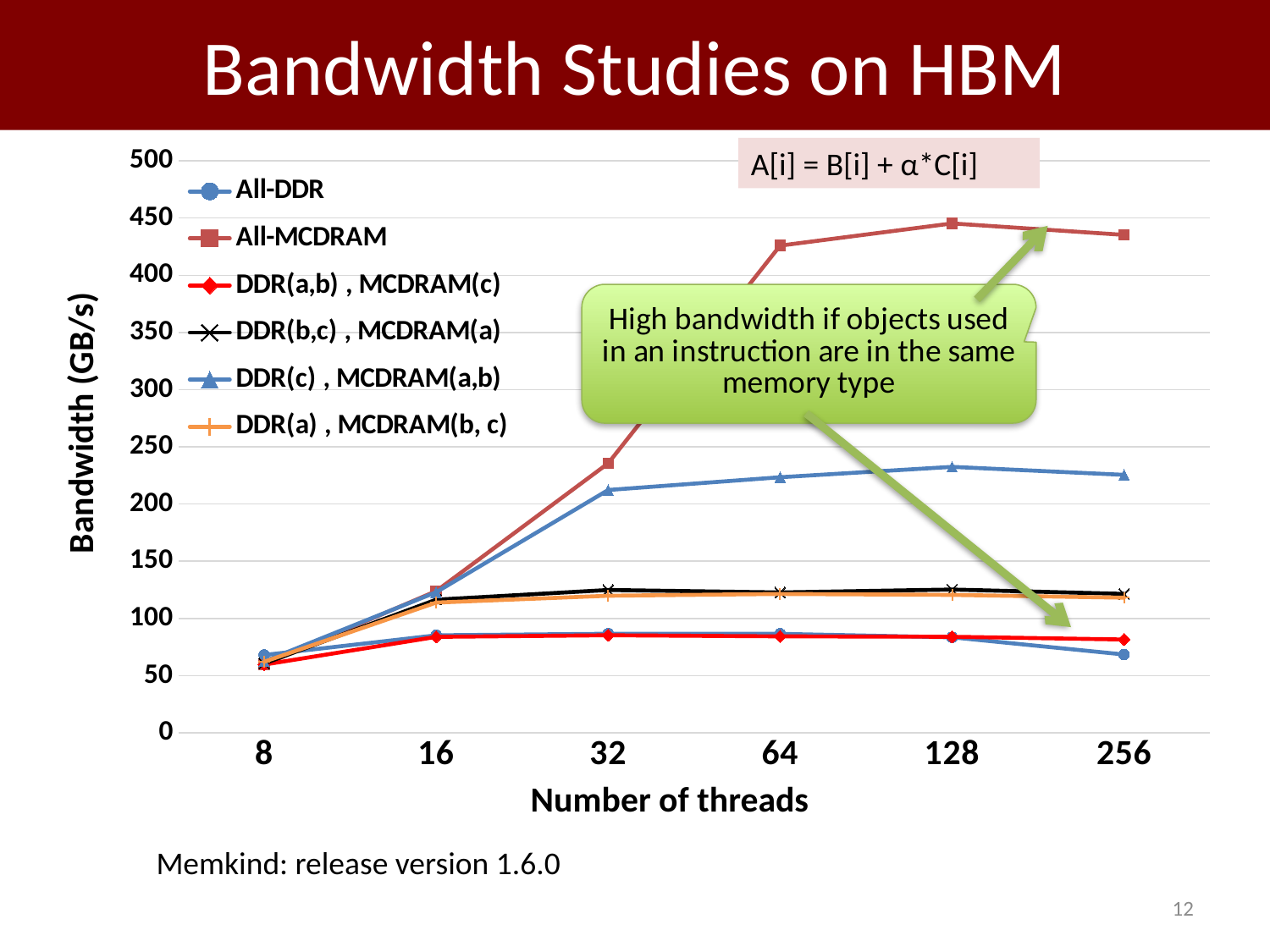
At 32 threads, which is larger: All-MCDRAM or DDR(c) , MCDRAM(a,b)? All-MCDRAM Is the value for All-MCDRAM at 128 threads greater or less than 400? greater Does the All-MCDRAM series rise or fall from 8 to 128 threads? rise Which series has the lowest bandwidth at 256 threads? All-DDR What is the label of the y axis? Bandwidth (GB/s) Which series has the highest bandwidth at 256 threads? All-MCDRAM What kind of chart is shown on the slide? line chart Is the value for DDR(b,c) , MCDRAM(a) at 128 threads greater or less than 150? less How many thread counts are plotted along the x axis? 6 Is the value for All-DDR at 256 threads greater or less than 100? less How many series does the legend list? 6